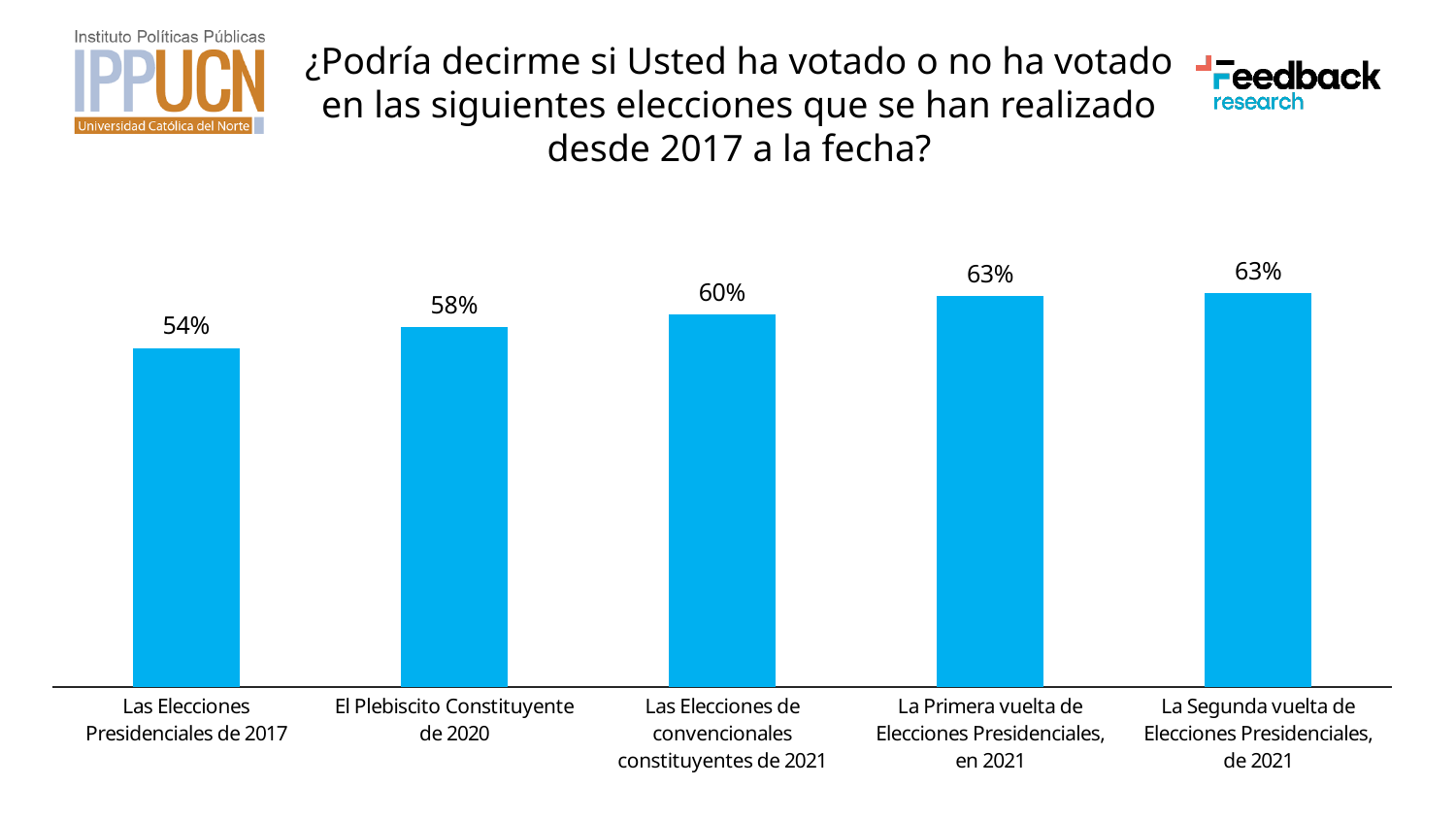
What percentage is shown for Las Elecciones de convencionales constituyentes de 2021? 60% What colour are the bars in the chart? Blue Do the percentages rise or fall from left to right across the chart? Rise Which is larger: the percentage for El Plebiscito Constituyente de 2020 or for Las Elecciones Presidenciales de 2017? El Plebiscito Constituyente de 2020 What percentage is shown for Las Elecciones Presidenciales de 2017? 54% What is the difference between the percentage for Las Elecciones de convencionales constituyentes de 2021 and El Plebiscito Constituyente de 2020? 2% What is the difference between the percentage for La Segunda vuelta de Elecciones Presidenciales, de 2021 and Las Elecciones Presidenciales de 2017? 9% What percentage is shown for La Primera vuelta de Elecciones Presidenciales, en 2021? 63% What percentage is shown for El Plebiscito Constituyente de 2020? 58% Which election has the lowest percentage? Las Elecciones Presidenciales de 2017 How many elections are shown in the chart? 5 What kind of chart is shown on the slide? Bar chart